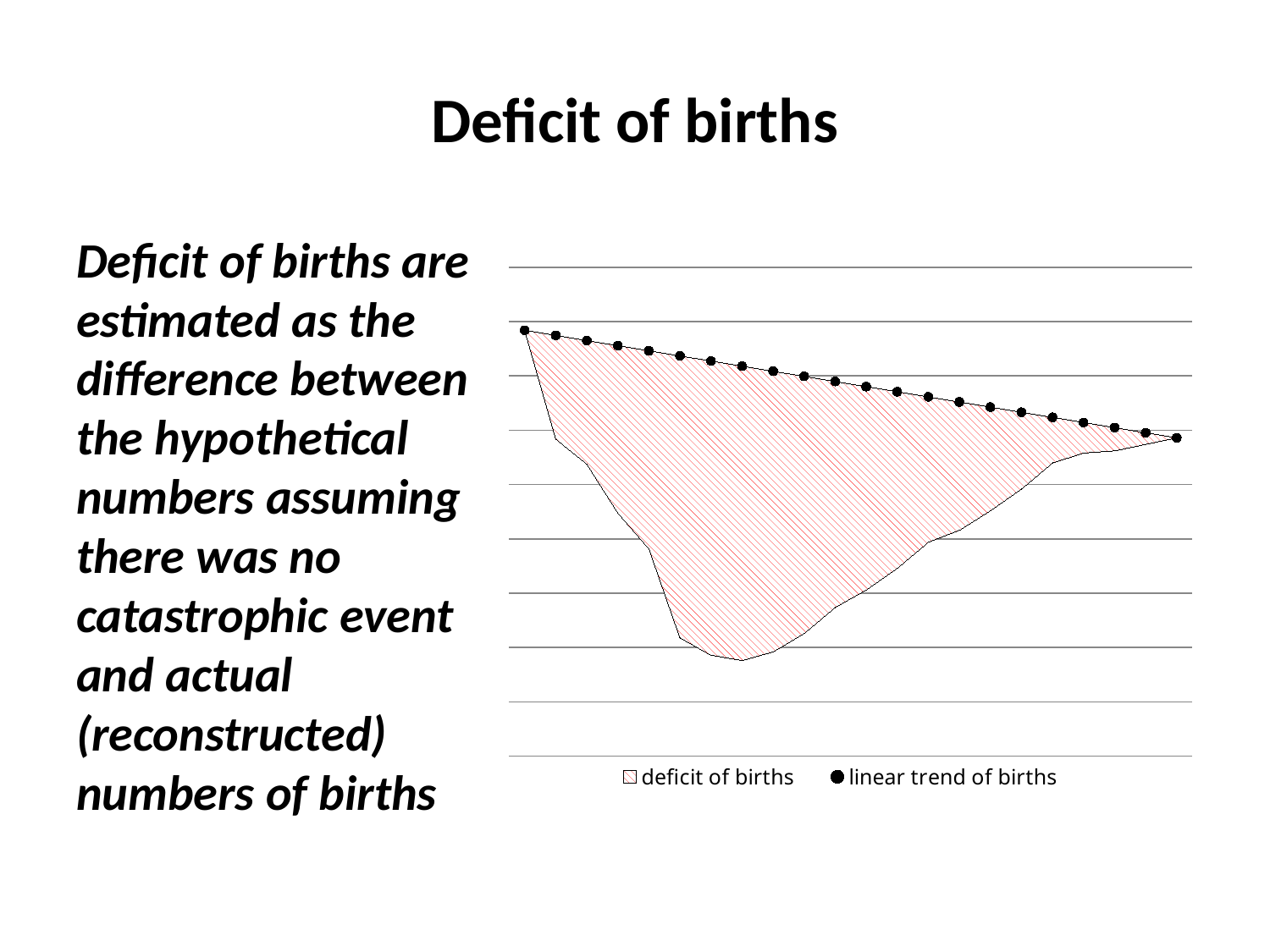
What is the title of the slide containing the chart? Deficit of births Does the linear trend of births rise or fall from left to right along the x axis? fall Which series is drawn with black circular markers? linear trend of births How many series does the chart legend list? 2 What kind of chart is shown on the slide? area chart with a line of markers What are the two series named in the chart legend? deficit of births and linear trend of births